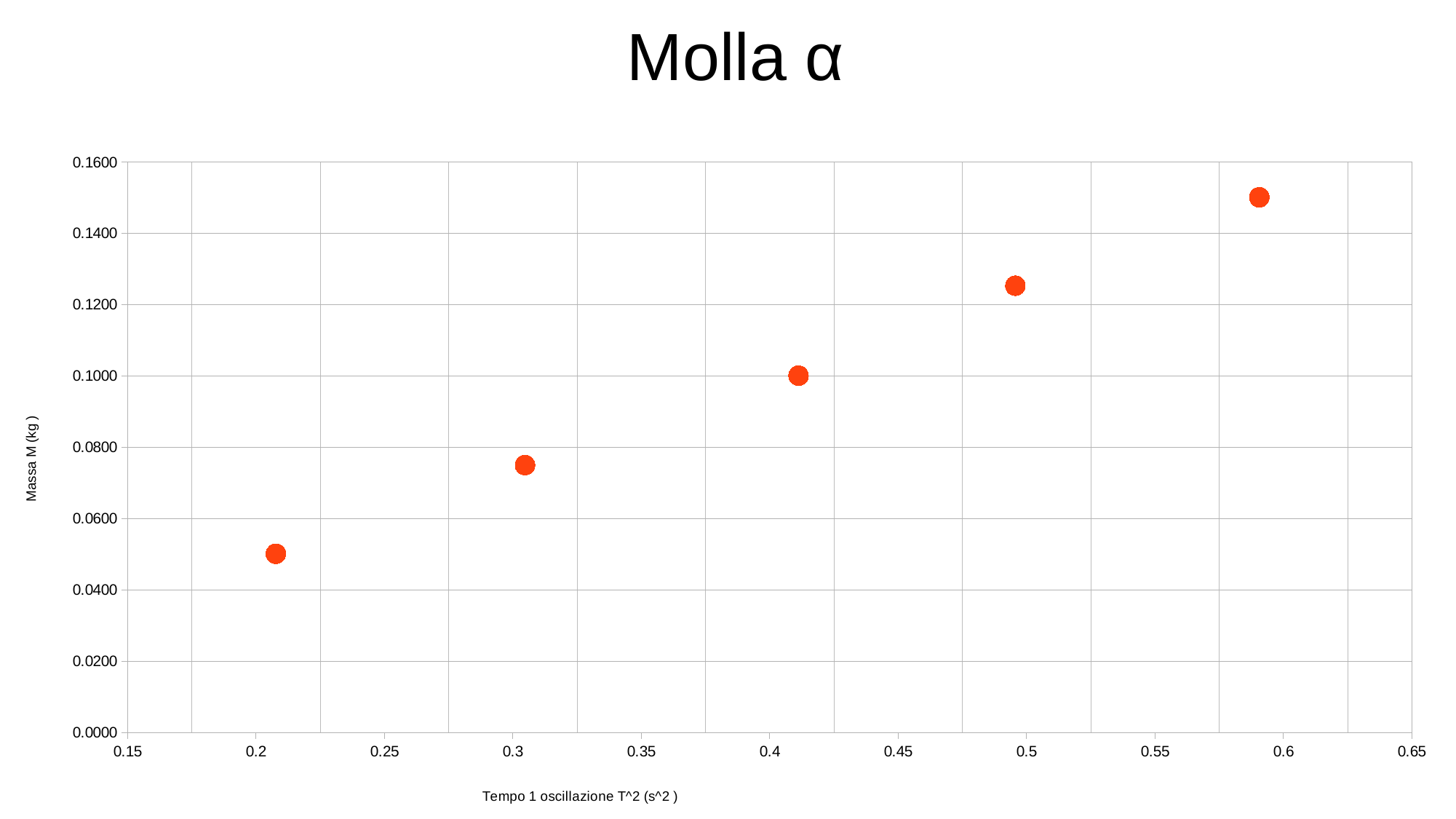
Is the mass value for the rightmost point (near T^2 = 0.6) greater or less than 0.1400? greater What is the label of the y axis? Massa M (kg ) Which has the larger mass value: the point near T^2 = 0.3 or the point near T^2 = 0.5? the point near T^2 = 0.5 What kind of chart is shown on the slide? scatter chart How many data points are plotted in the chart? 5 Which point has the lowest mass value? the leftmost point (near T^2 = 0.2) Do the mass values rise or fall as T^2 increases along the x axis? rise What is the title of the chart? Molla α Is the mass value for the leftmost point (near T^2 = 0.2) greater or less than 0.0600? less Which point has the highest mass value? the rightmost point (near T^2 = 0.6) Is the mass value for the point near T^2 = 0.5 greater or less than 0.1200? greater